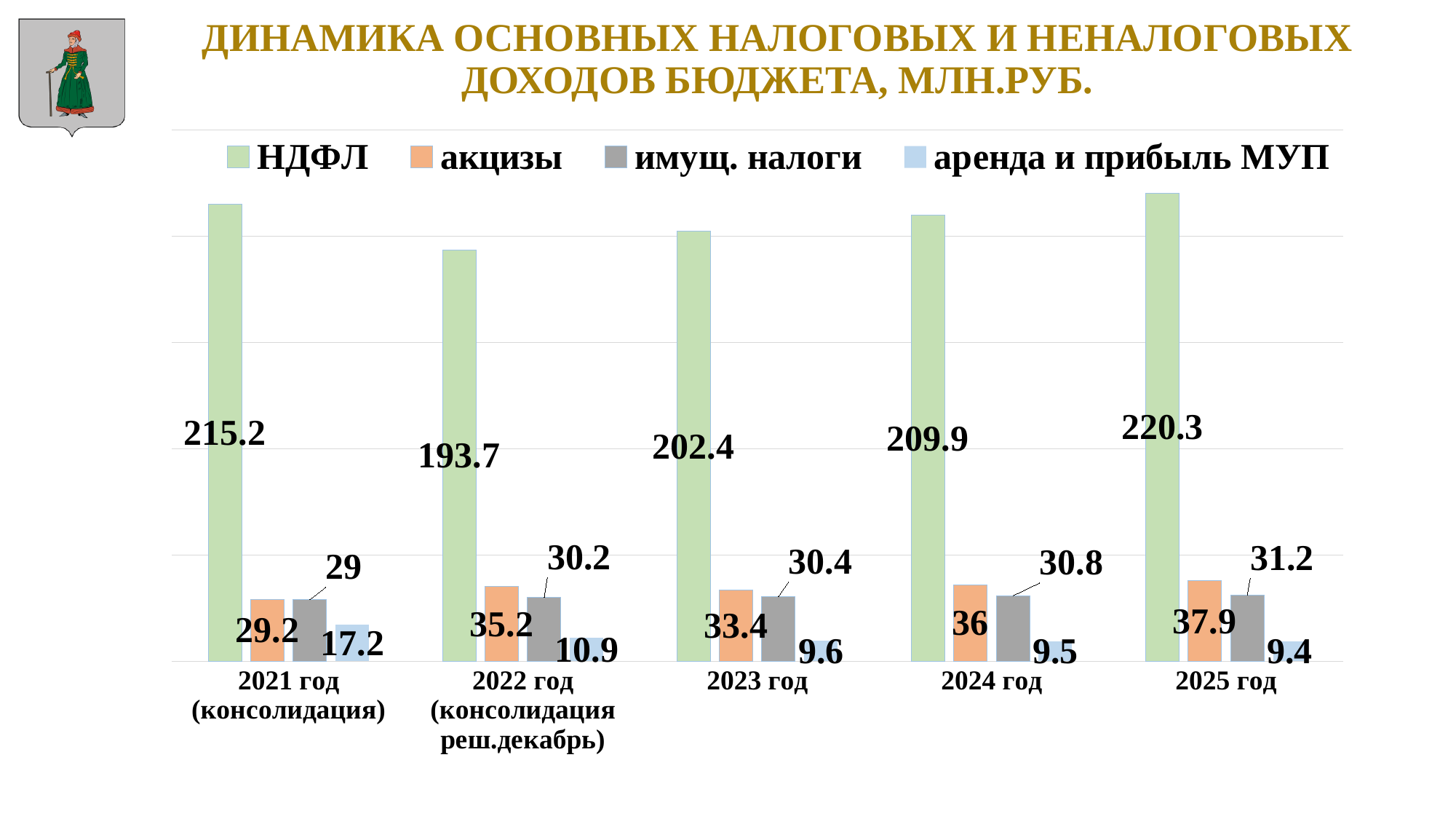
In which year is the НДФЛ value the highest? 2025 год What is the value of аренда и прибыль МУП for 2022 год (консолидация реш.декабрь)? 10.9 How many series does the legend list? 4 What is the имущ. налоги value for 2024 год? 30.8 What is the акцизы value for 2025 год? 37.9 What is the difference between the НДФЛ values for 2025 год and 2021 год (консолидация)? 5.1 What is the НДФЛ value for 2021 год (консолидация)? 215.2 In which year is the НДФЛ value the lowest? 2022 год (консолидация реш.декабрь) What kind of chart is shown on the slide? bar chart How many year categories are shown on the x axis? 5 Does the value of аренда и прибыль МУП rise or fall from 2021 to 2025? fall Which is larger: акцизы in 2023 год or акцизы in 2024 год? акцизы in 2024 год